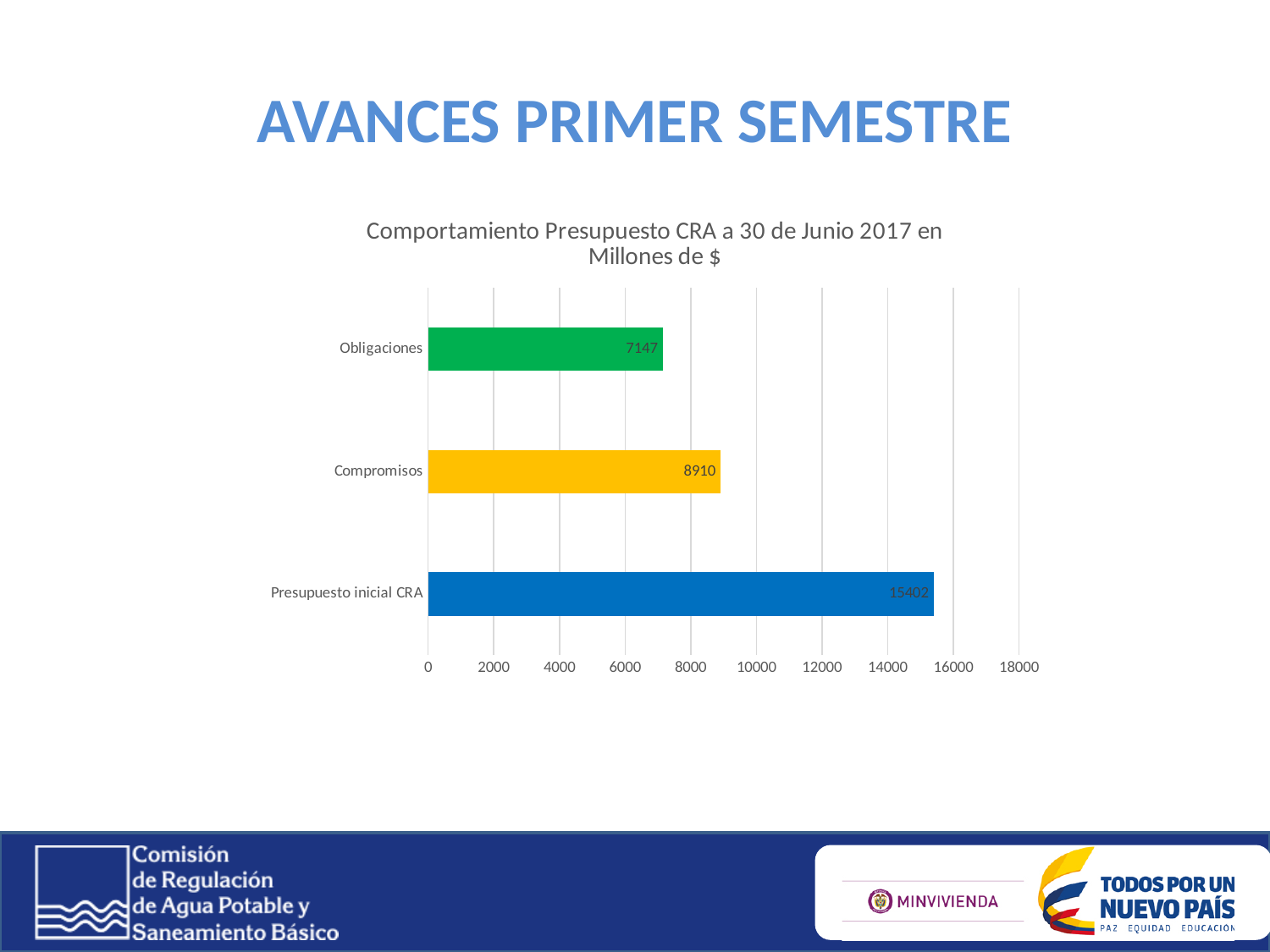
What is the difference between Presupuesto inicial CRA and Compromisos? 6492 What is the title of the chart? Comportamiento Presupuesto CRA a 30 de Junio 2017 en Millones de $ What kind of chart is shown on the slide? Bar chart Which category has the highest value? Presupuesto inicial CRA What is the value for Compromisos? 8910 What is the difference between Compromisos and Obligaciones? 1763 Which is larger, Compromisos or Obligaciones? Compromisos What is the value for Obligaciones? 7147 How many categories are shown in the chart? 3 Is the value for Presupuesto inicial CRA greater or less than 14000? greater Which category has the lowest value? Obligaciones What is the value for Presupuesto inicial CRA? 15402